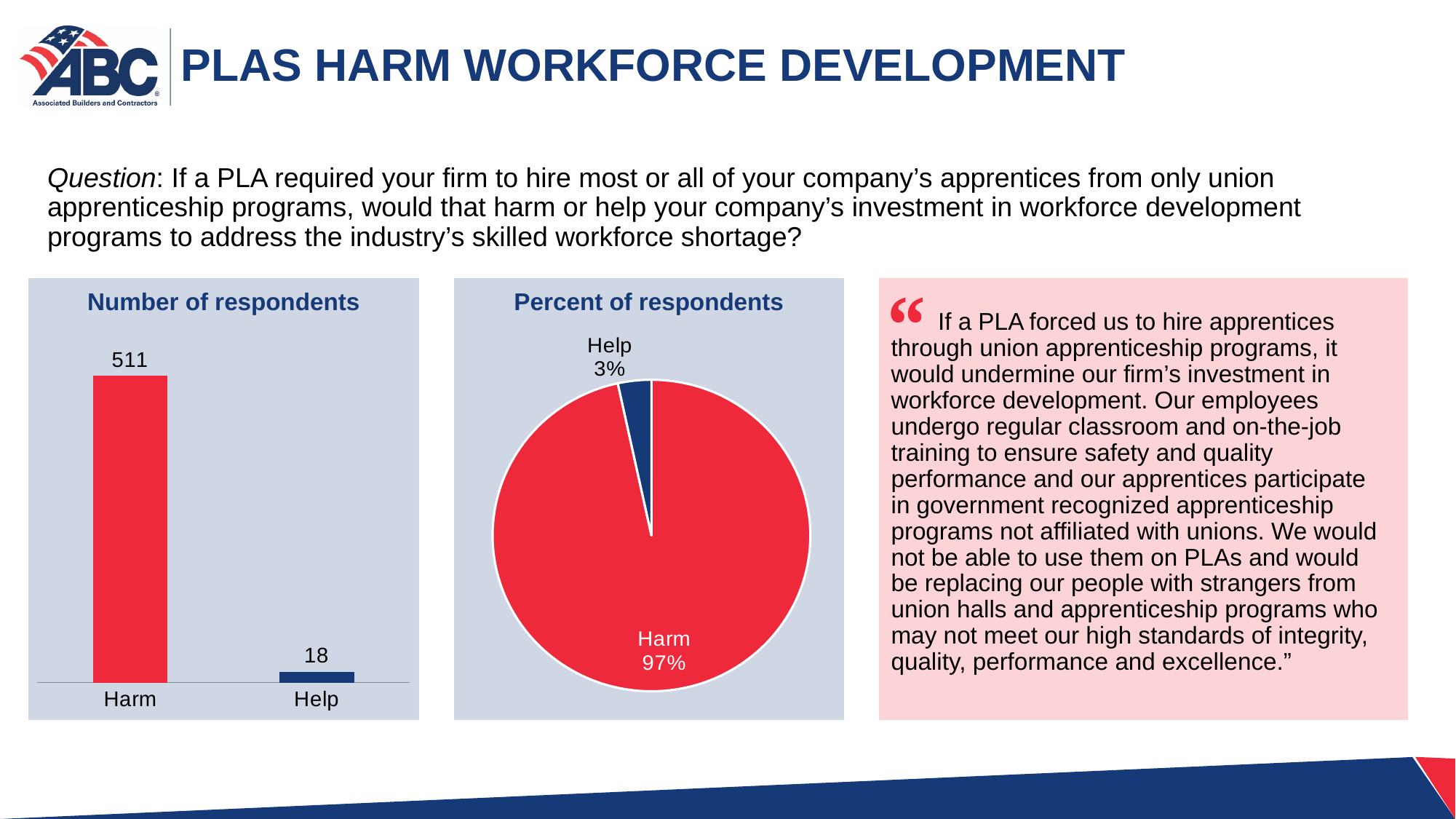
In the 'Percent of respondents' chart, what share of respondents answered Harm? 97% In the 'Percent of respondents' chart, which slice is larger, Harm or Help? Harm In the 'Number of respondents' chart, what is the value for Harm? 511 In the 'Percent of respondents' chart, what colour is the Harm slice? Red What kind of chart is the 'Percent of respondents' chart? Pie chart In the 'Number of respondents' chart, what is the value for Help? 18 In the 'Number of respondents' chart, how many categories are shown? 2 In the 'Number of respondents' chart, which category has the lowest value? Help In the 'Number of respondents' chart, which category has the highest value? Harm In the 'Number of respondents' chart, what is the difference between the Harm and Help values? 493 What kind of chart is the 'Number of respondents' chart? Bar chart In the 'Percent of respondents' chart, what share of respondents answered Help? 3%